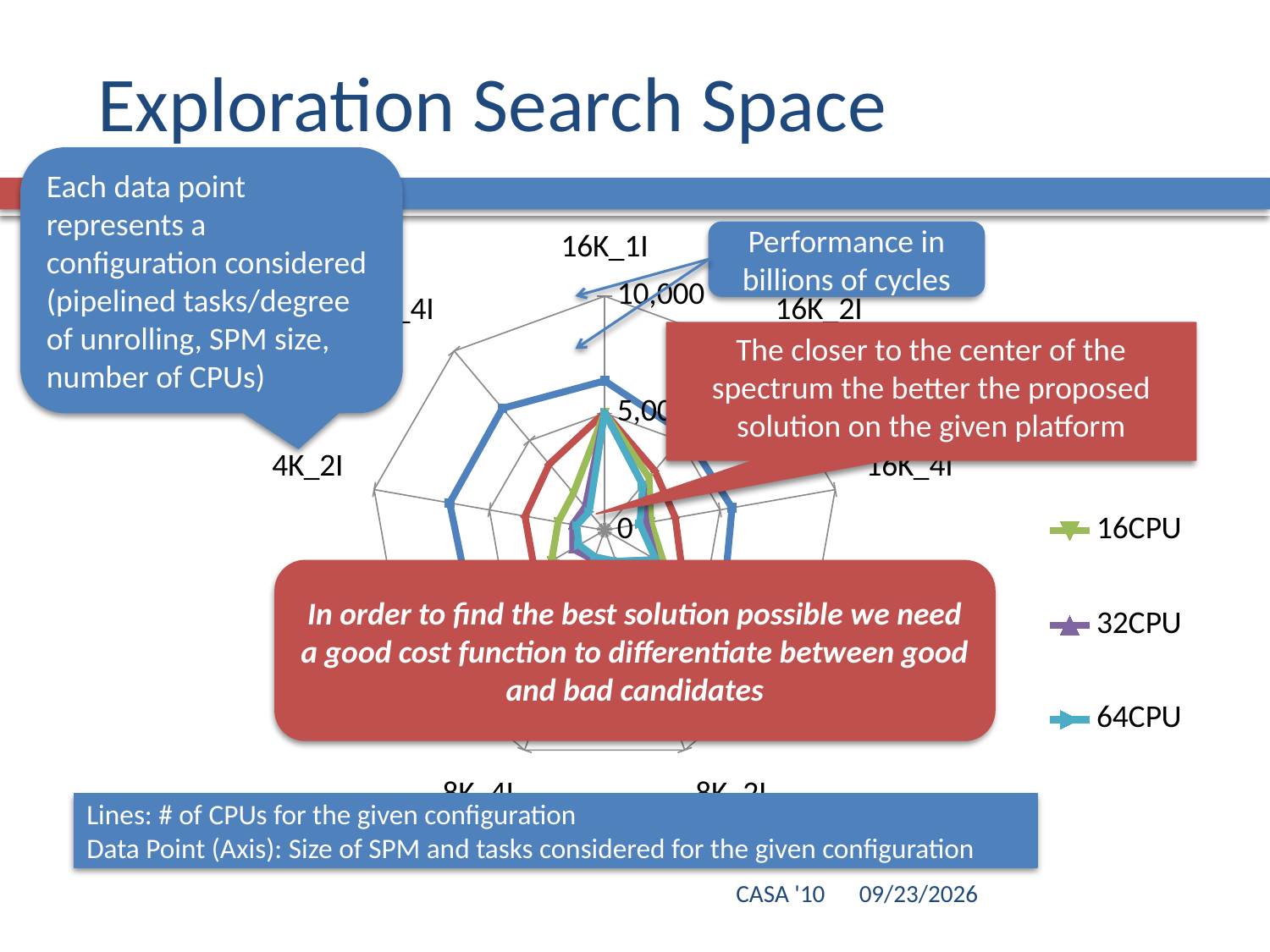
What is the highest value labelled on the chart's radial axis? 10,000 How many axes (spokes) does the radar chart have? 9 Which series names are readable in the chart legend? 16CPU, 32CPU, 64CPU What kind of chart is shown on the slide? radar chart Is the value of the 32CPU series at 4K_2I greater or less than 5,000? less Is the value of the outermost (blue) line at 16K_1I greater or less than 5,000? greater